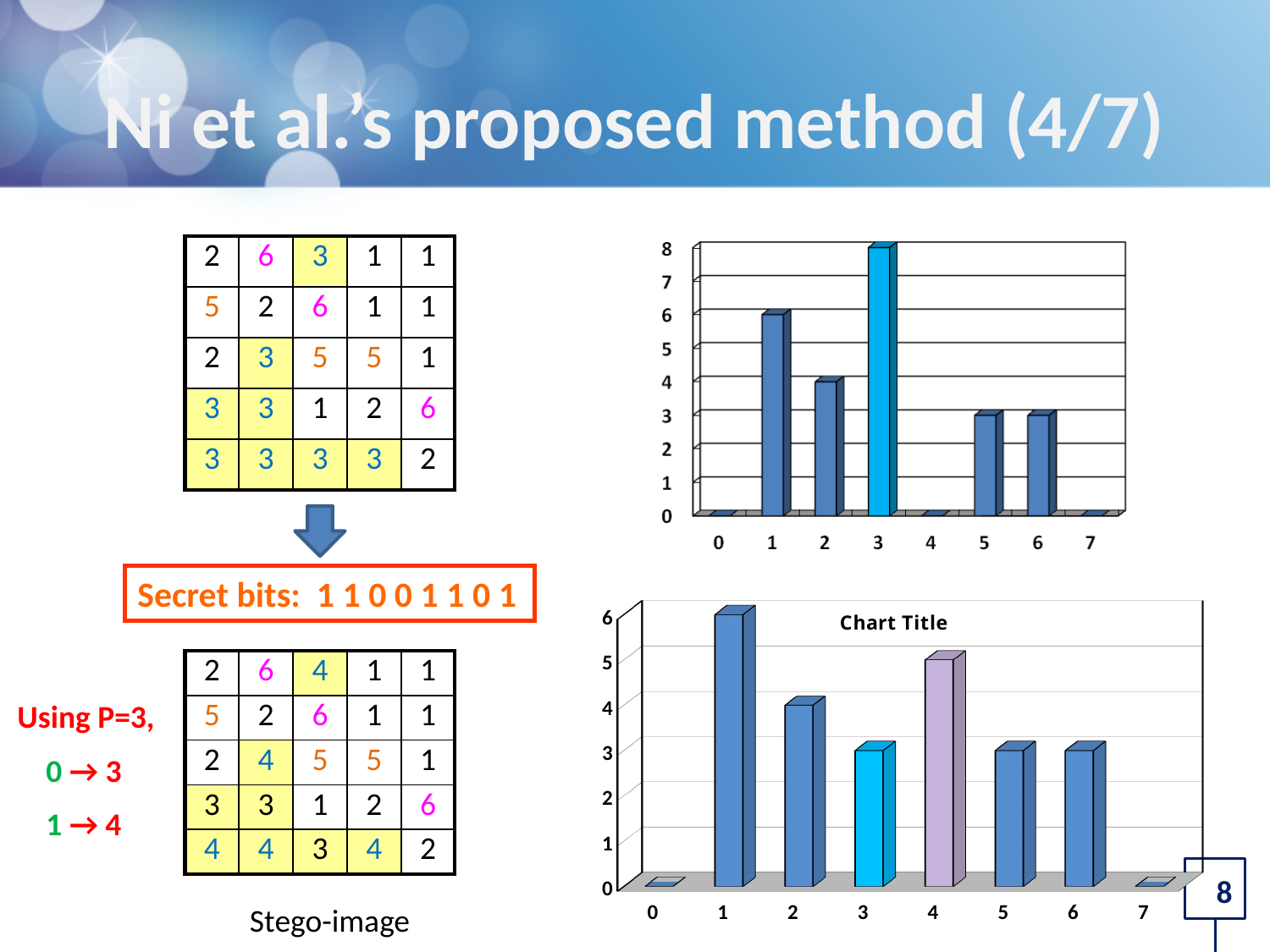
In the top chart, what is the value for category 3? 8 In the bottom chart titled 'Chart Title', which category has the highest bar? 1 In the top chart, what is the value for category 1? 6 In the top chart, which category has the highest bar? 3 In the top chart, how many categories are shown on the x axis? 8 In the top chart, what is the difference between the values for categories 3 and 1? 2 What kind of chart is the bottom chart titled 'Chart Title'? bar chart In the top chart, is the value for category 2 greater or less than 3? greater In the bottom chart titled 'Chart Title', what is the value for category 4? 5 What is the title of the bottom chart? Chart Title In the bottom chart titled 'Chart Title', what is the difference between the values for categories 1 and 4? 1 In the bottom chart titled 'Chart Title', which is larger, the value for category 2 or the value for category 3? category 2